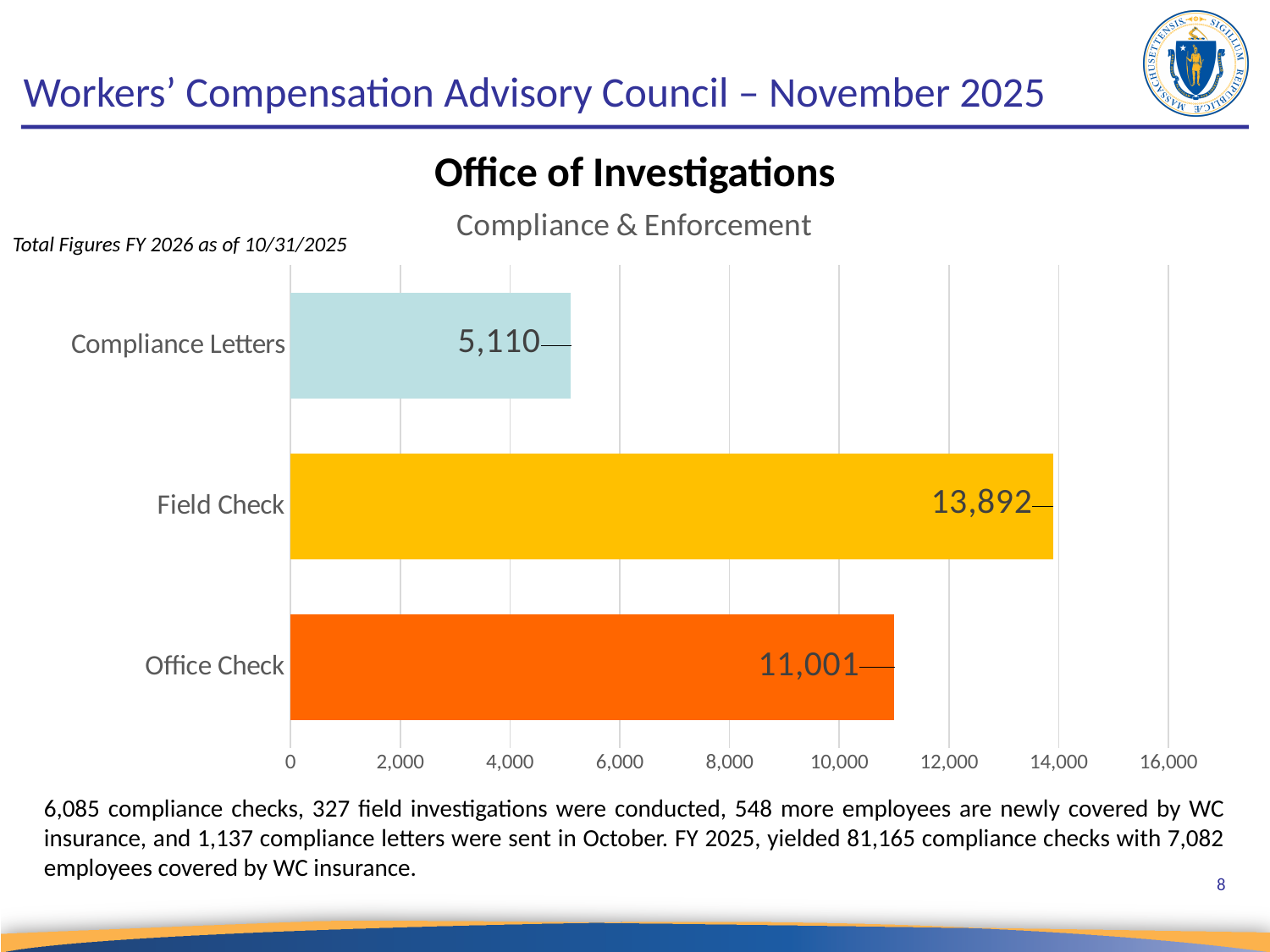
Which is larger, Office Check or Compliance Letters? Office Check What kind of chart is shown on the slide? Bar chart What is the difference between the Field Check and Office Check values? 2,891 Is the value for Field Check greater or less than 12,000? greater What is the value for Office Check? 11,001 Which category has the highest value? Field Check How many categories are shown in the chart? 3 What is the title of the chart? Compliance & Enforcement What is the difference between the Office Check and Compliance Letters values? 5,891 What is the value for Field Check? 13,892 Which category has the lowest value? Compliance Letters What is the value for Compliance Letters? 5,110